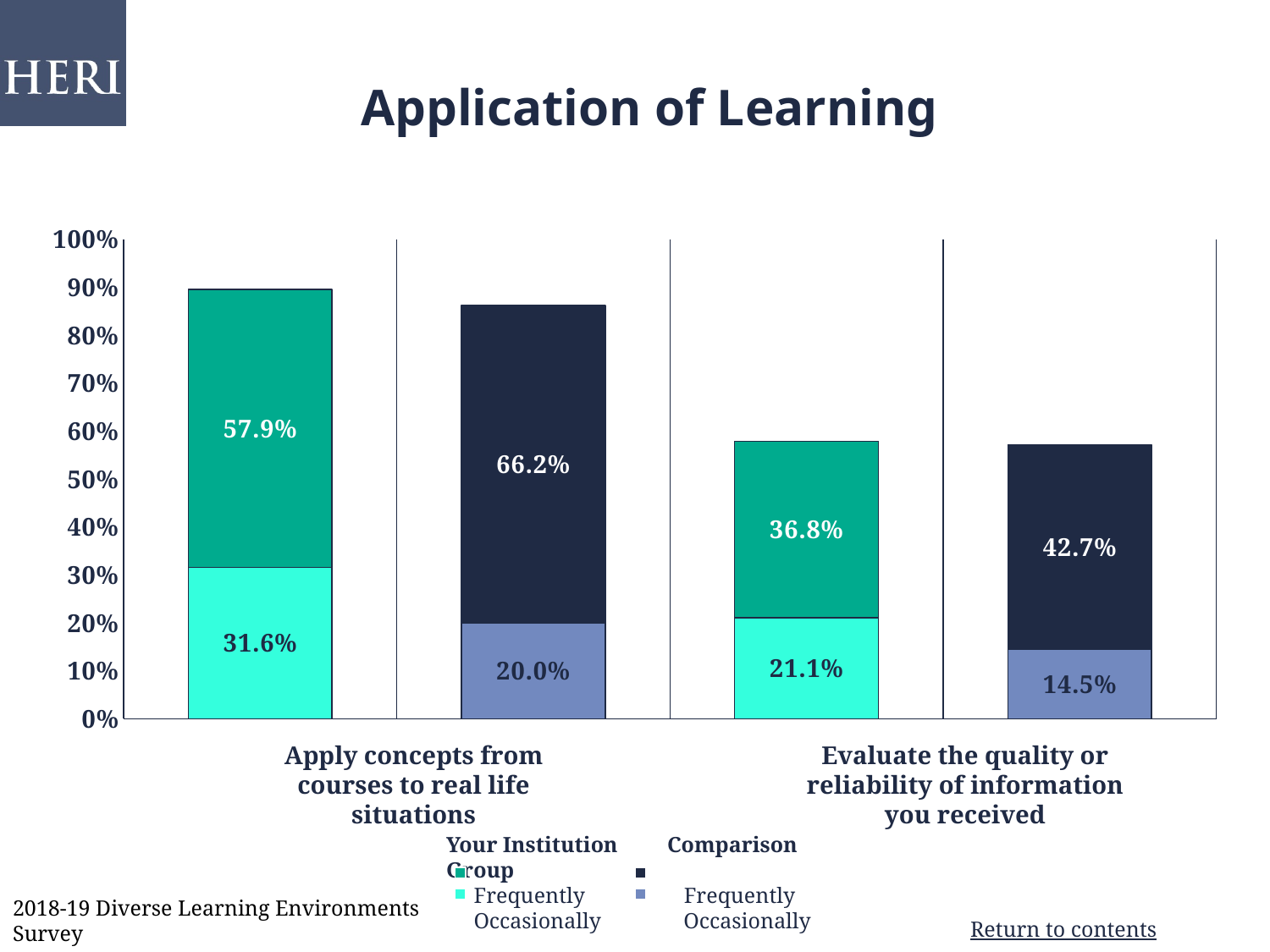
What is the title of the chart on the slide? Application of Learning Which of the four 'Frequently' values shown on the chart is the lowest? Your Institution, Evaluate the quality or reliability of information you received (36.8%) What percentage of the Comparison Group reported 'Occasionally' applying concepts from courses to real life situations? 20.0% How many question categories are shown along the x axis of the chart? 2 What is the difference between Your Institution's 'Frequently' value and the Comparison Group's 'Frequently' value for 'Apply concepts from courses to real life situations'? 8.3% What is the total (Frequently plus Occasionally) for Your Institution on 'Apply concepts from courses to real life situations'? 89.5% Which is larger for 'Evaluate the quality or reliability of information you received': Your Institution's 'Occasionally' value or the Comparison Group's 'Occasionally' value? Your Institution's 'Occasionally' value (21.1%) What is the total (Frequently plus Occasionally) for the Comparison Group on 'Evaluate the quality or reliability of information you received'? 57.2% What percentage of Your Institution students reported 'Occasionally' evaluating the quality or reliability of information they received? 21.1% What percentage of Your Institution students reported 'Frequently' applying concepts from courses to real life situations? 57.9% What percentage of the Comparison Group reported 'Frequently' evaluating the quality or reliability of information they received? 42.7% What kind of chart is shown on the slide? Stacked bar chart